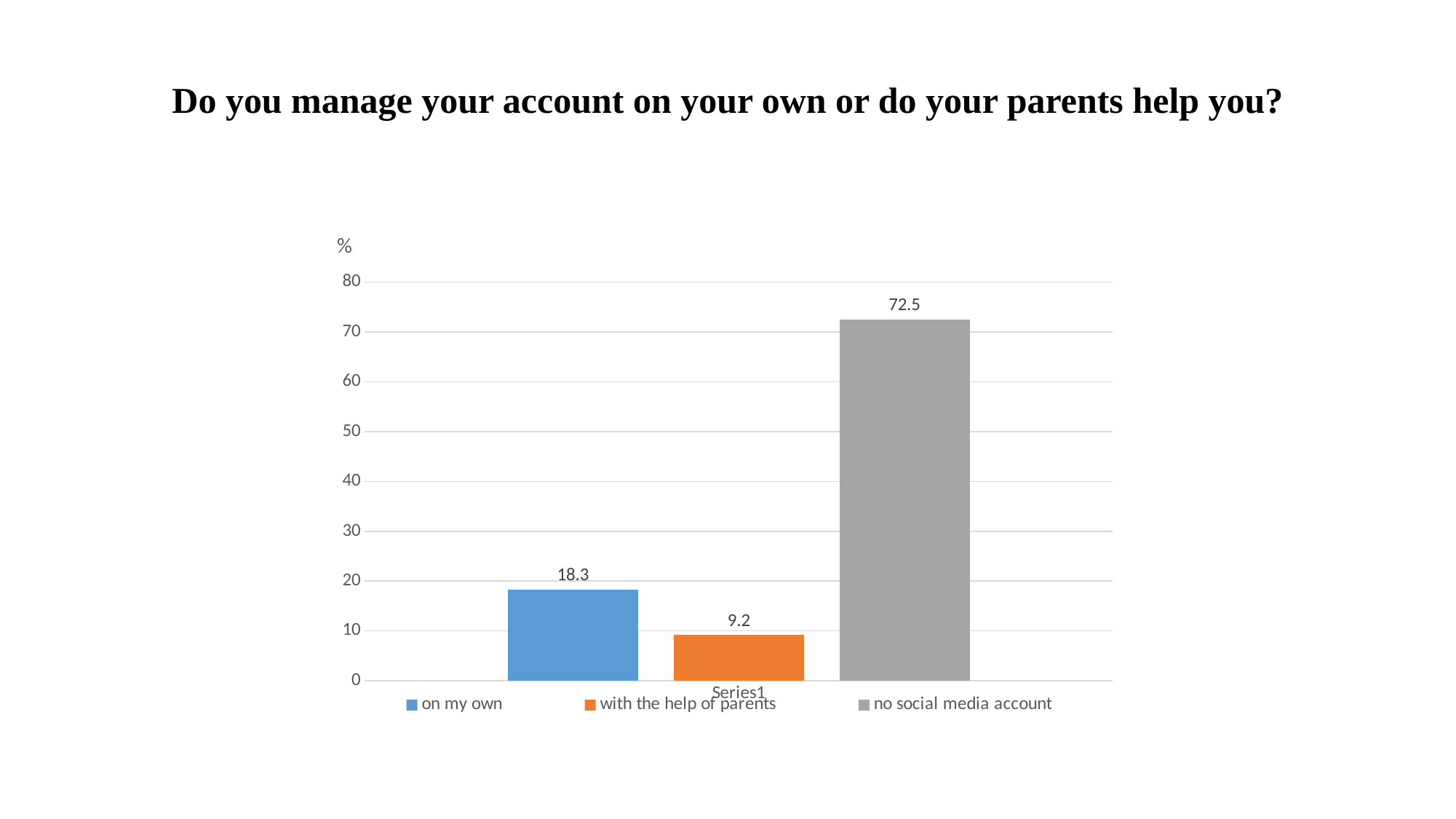
How many entries does the legend list? 3 Which category has the highest value? no social media account Which category has the lowest value? with the help of parents What is the value for "with the help of parents"? 9.2 Is the value for "no social media account" greater or less than 70? greater What is the value for "on my own"? 18.3 What colour is the bar for "no social media account"? grey What is the value for "no social media account"? 72.5 What is the difference between the values for "on my own" and "with the help of parents"? 9.1 What is the difference between the values for "no social media account" and "on my own"? 54.2 Which is larger, the value for "on my own" or the value for "with the help of parents"? on my own What kind of chart is shown on the slide? bar chart